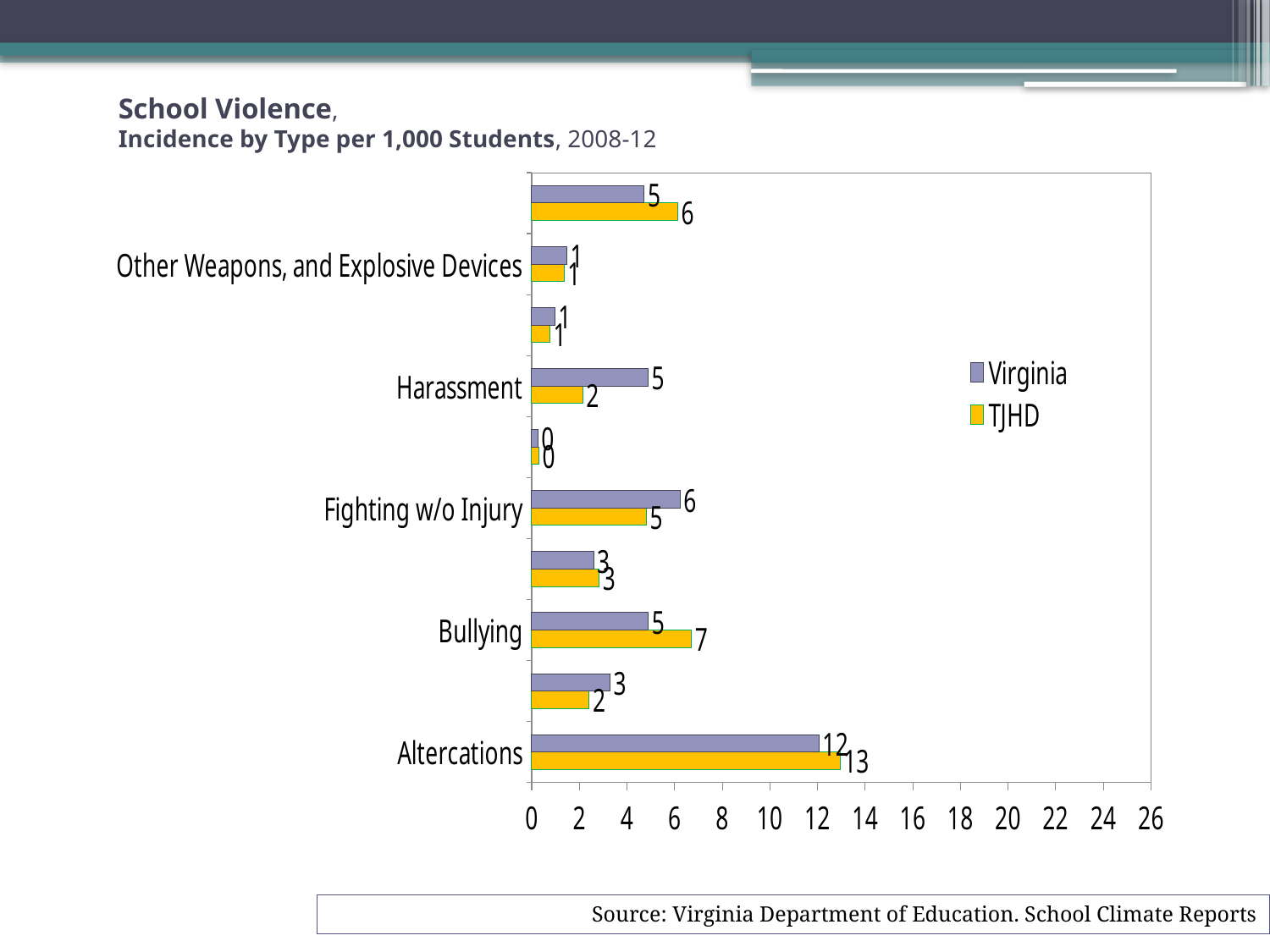
What is the TJHD value for Harassment? 2 What are the two entries in the chart's legend? Virginia and TJHD For Bullying, which series has the larger value, Virginia or TJHD? TJHD What kind of chart is shown on the slide? Bar chart What is the difference between the Virginia and TJHD values for Harassment? 3 Which labeled category has the highest TJHD value? Altercations How many series does the legend list? 2 What is the TJHD value for Altercations? 13 What is the Virginia value for Fighting w/o Injury? 6 What is the Virginia value for Altercations? 12 What is the TJHD value for Bullying? 7 What is the Virginia value for Harassment? 5